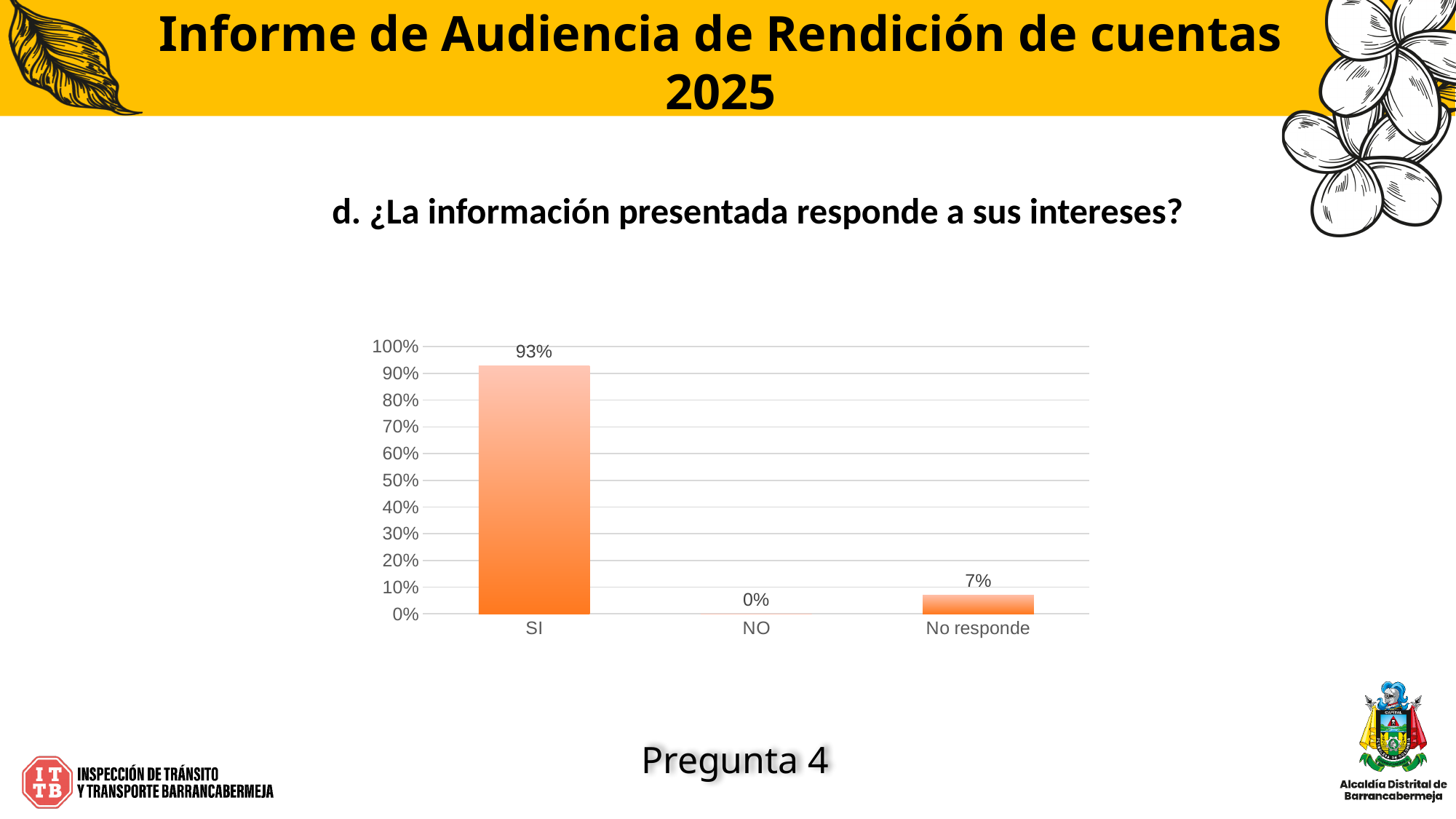
What is the value for SI? 93% What is the value for NO? 0% What is the difference between the values for SI and No responde? 86% Is the value for No responde greater or less than 10%? less Which category has the lowest value? NO Which category has the highest value? SI How many categories are shown on the x axis? 3 Which is larger, the value for SI or the value for No responde? SI What kind of chart is shown? bar chart What is the value for No responde? 7% Is the value for SI greater or less than 90%? greater What question does the chart answer, as written above it? d. ¿La información presentada responde a sus intereses?